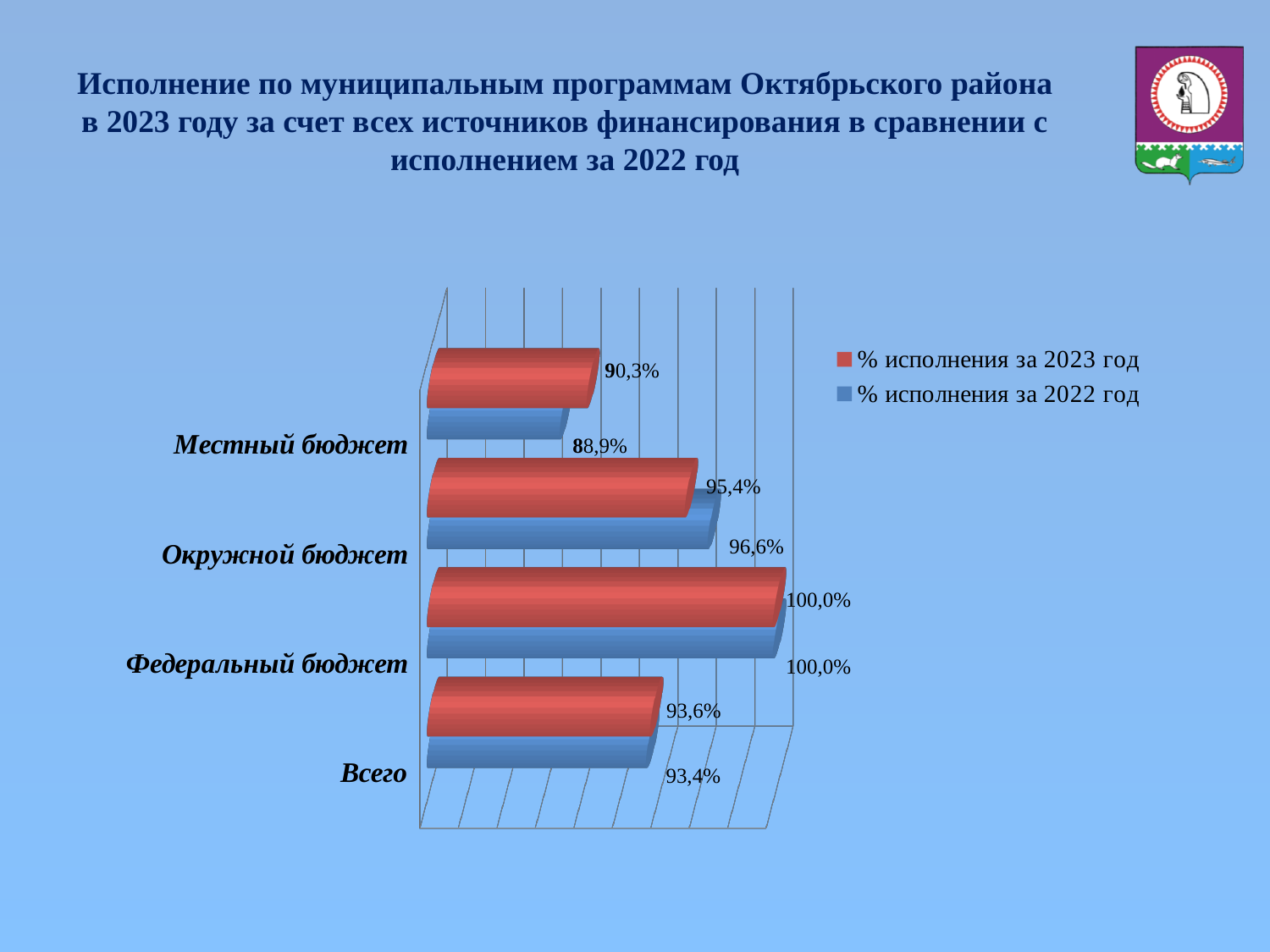
How many categories are shown on the chart? 4 What is the difference between the 2022 and 2023 values for Окружной бюджет? 1,2% What is the value of % исполнения за 2022 год for Местный бюджет? 88,9% What is the value of % исполнения за 2023 год for Окружной бюджет? 95,4% How many series does the legend list? 2 Which category has the lowest value for % исполнения за 2022 год? Местный бюджет What is the difference between the 2023 and 2022 values for Местный бюджет? 1,4% For Окружной бюджет, which is larger: % исполнения за 2023 год or % исполнения за 2022 год? % исполнения за 2022 год Which category has the highest value for % исполнения за 2023 год? Федеральный бюджет What kind of chart is shown on the slide? Bar chart What is the value of % исполнения за 2023 год for Местный бюджет? 90,3% What is the value of % исполнения за 2022 год for Всего? 93,4%